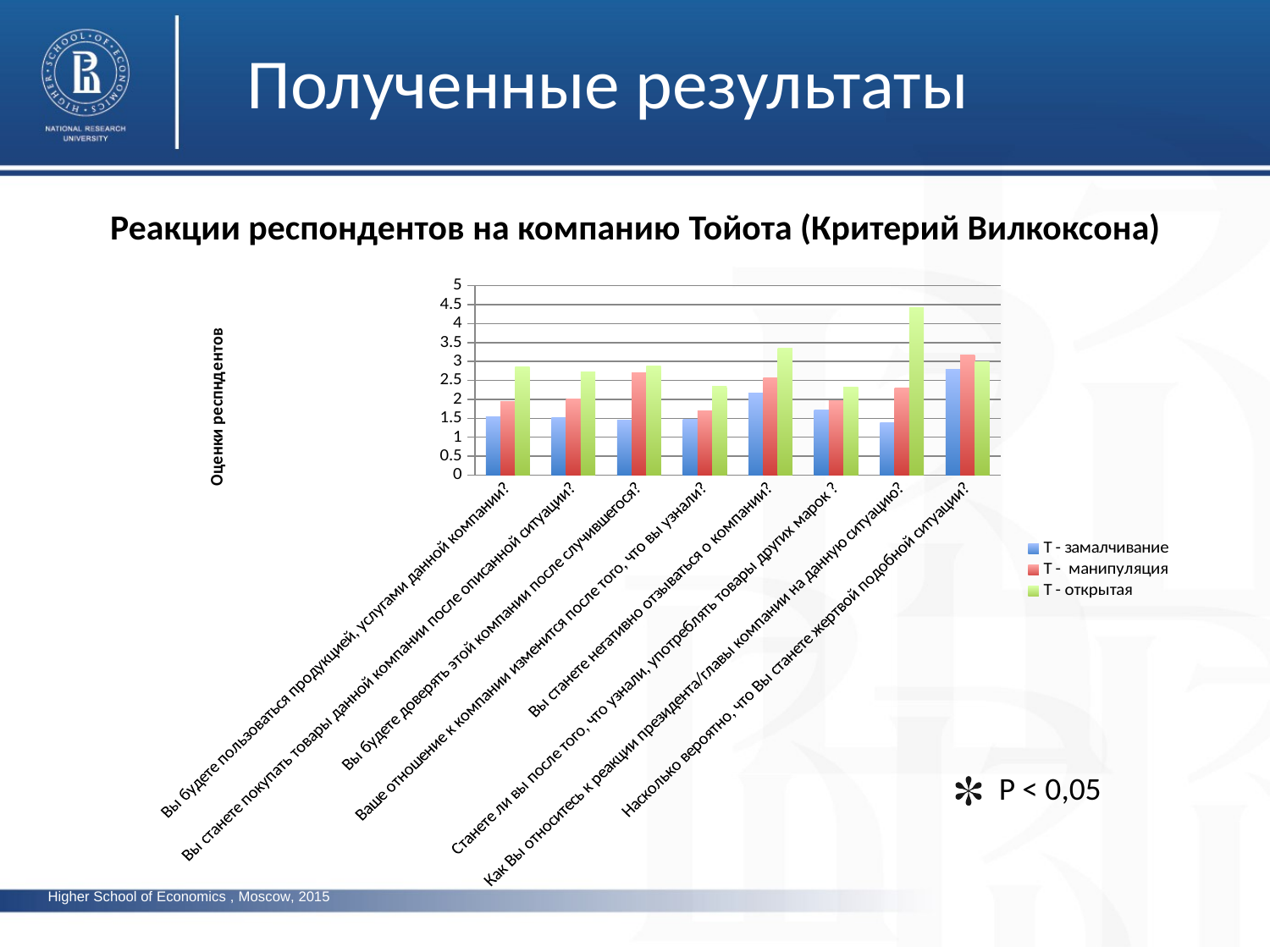
Is the value of "Т - замалчивание" for "Вы будете доверять этой компании после случившегося?" greater or less than 2? less What is the title of the chart? Реакции респондентов на компанию Тойота (Критерий Вилкоксона) Is the value of "Т - открытая" for "Как Вы относитесь к реакции президента/главы компании на данную ситуацию?" greater or less than 4? greater For "Вы будете доверять этой компании после случившегося?", which is larger: the value for "Т - замалчивание" or for "Т - манипуляция"? Т - манипуляция What kind of chart is shown on the slide? bar chart Which series has the highest bar for the category "Как Вы относитесь к реакции президента/главы компании на данную ситуацию?"? Т - открытая Is the value of "Т - манипуляция" for "Насколько вероятно, что Вы станете жертвой подобной ситуации?" greater or less than 3? greater Across all categories, which series has the single tallest bar in the chart? Т - открытая What is the label of the vertical axis? Оценки респндентов How many series does the legend list? 3 For "Вы станете негативно отзываться о компании?", which is larger: the value for "Т - замалчивание" or for "Т - открытая"? Т - открытая How many categories (questions) are plotted along the x axis? 8